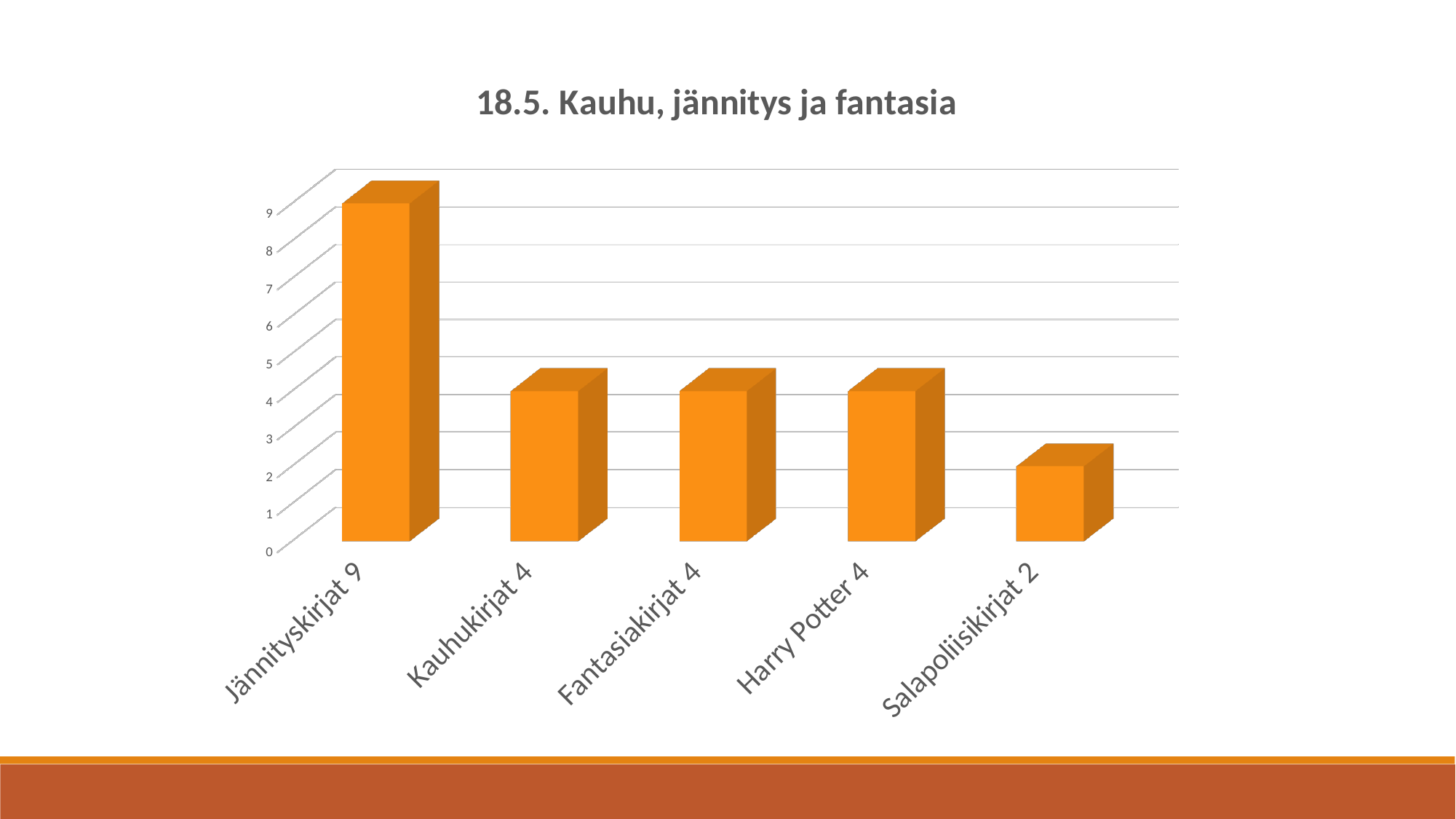
What kind of chart is shown on the slide? bar chart Which is larger, the value for Jännityskirjat or the value for Harry Potter? Jännityskirjat Is the value for Jännityskirjat greater or less than 5? greater Which category has the highest value? Jännityskirjat What is the value for Salapoliisikirjat? 2 What is the difference between the values for Fantasiakirjat and Salapoliisikirjat? 2 How many categories are shown in the chart? 5 What is the value for Harry Potter? 4 What is the difference between the values for Jännityskirjat and Kauhukirjat? 5 Which category has the lowest value? Salapoliisikirjat What is the value for Jännityskirjat? 9 What is the title of the chart? 18.5. Kauhu, jännitys ja fantasia